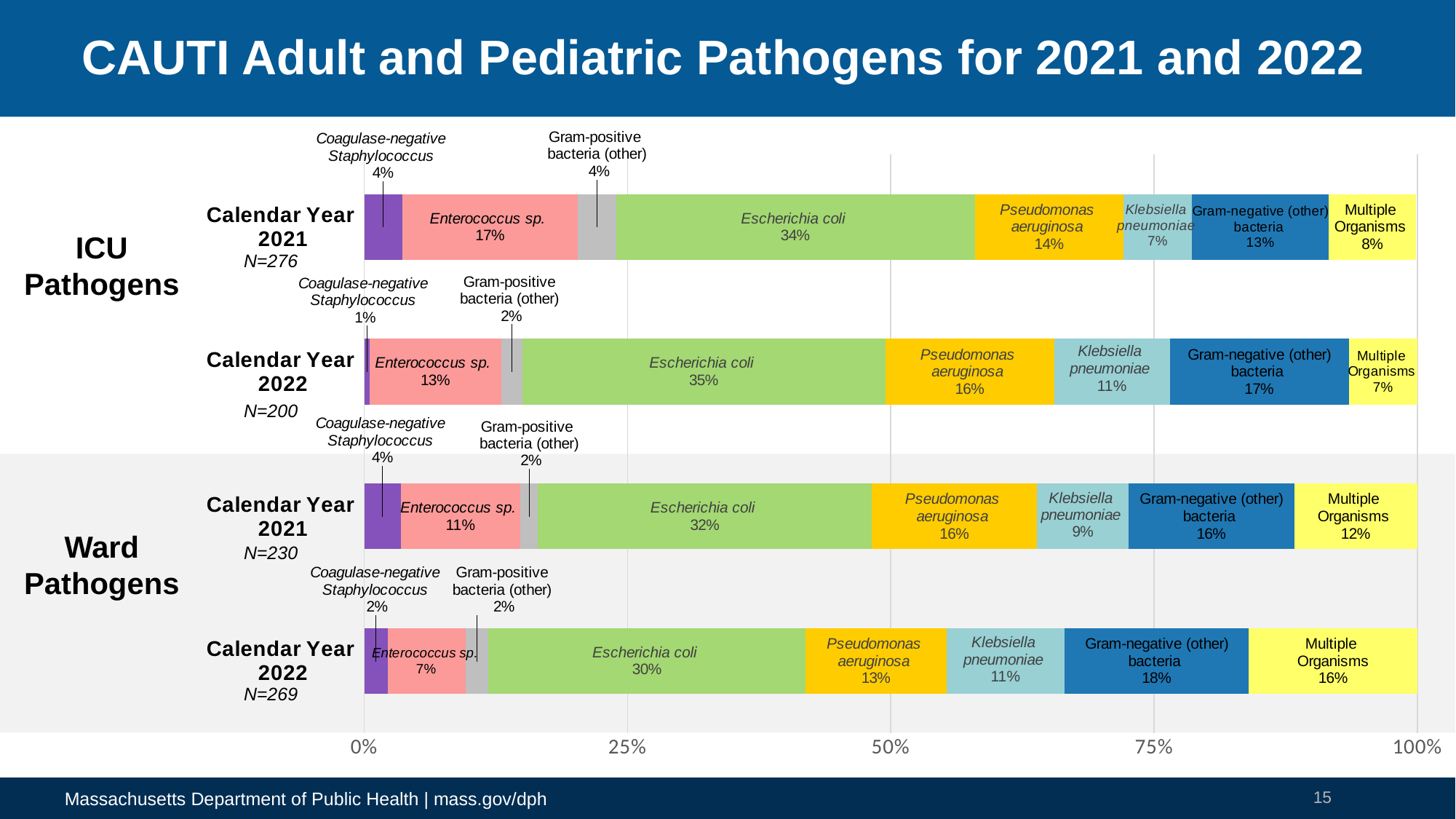
Did the Escherichia coli share of Ward pathogens rise or fall from Calendar Year 2021 to Calendar Year 2022? Fall What percentage of Ward pathogens in Calendar Year 2022 was Gram-negative (other) bacteria? 18% What is the N value for Ward pathogens in Calendar Year 2021? N=230 Was the Pseudomonas aeruginosa share of ICU pathogens larger in Calendar Year 2021 or Calendar Year 2022? Calendar Year 2022 What kind of chart is shown on the slide? Stacked bar chart Which pathogen has the smallest share of ICU pathogens in Calendar Year 2022? Coagulase-negative Staphylococcus How many pathogen segments make up each stacked bar? 8 What percentage of ICU pathogens in Calendar Year 2021 was Klebsiella pneumoniae? 7% By how many percentage points did the Multiple Organisms share of Ward pathogens change from Calendar Year 2021 to Calendar Year 2022? 4 percentage points Which pathogen has the largest share of ICU pathogens in Calendar Year 2022? Escherichia coli How many stacked bars are shown in the chart? 4 What percentage of ICU pathogens in Calendar Year 2021 was Escherichia coli? 34%